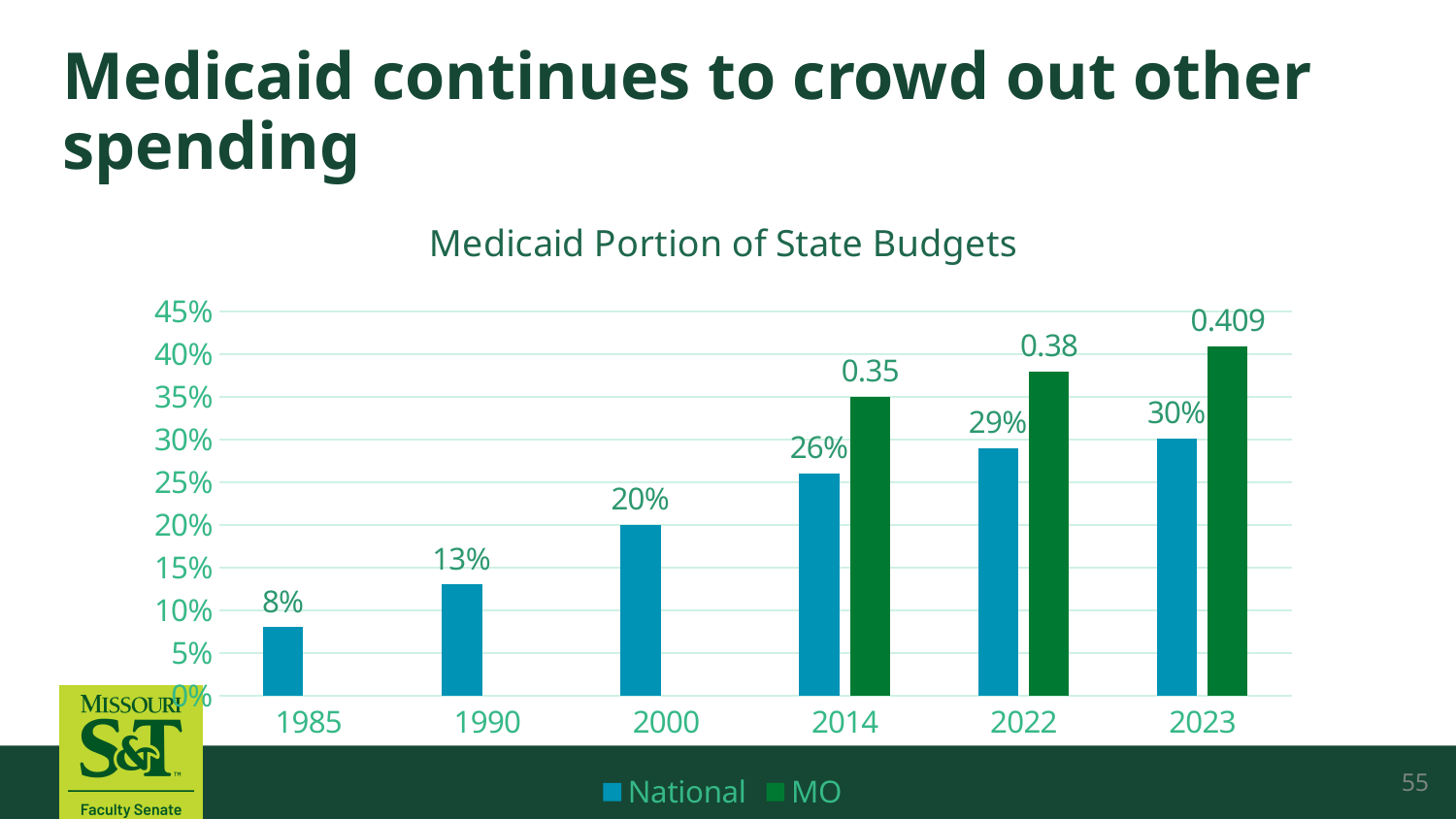
Which year has the highest MO value? 2023 What is the MO value for 2022? 0.38 In 2014, which is larger, the National bar or the MO bar? MO How many years are shown on the x axis? 6 How many series does the legend list? 2 What is the National value for 1985? 8% What kind of chart is shown? Bar chart Do the National values rise or fall from 1985 to 2023? Rise What is the difference between the National values for 2023 and 1985? 22 percentage points What is the MO value for 2023? 0.409 What is the National value for 2014? 26% Which year has the lowest National value? 1985